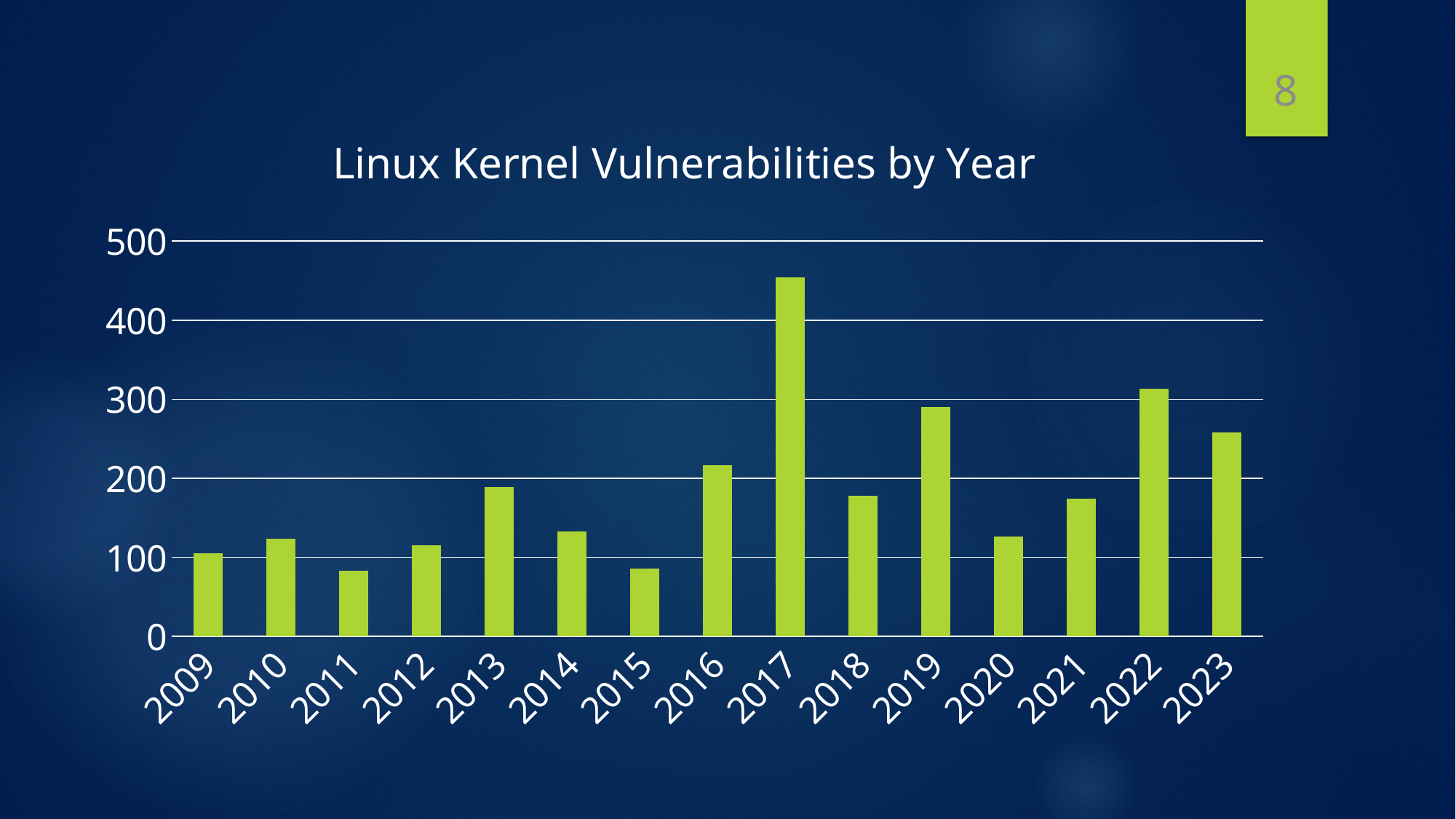
Is the value for 2013 greater or less than 200? less What kind of chart is shown on the slide? bar chart Is the value for 2016 greater or less than 200? greater What is the title of the chart? Linux Kernel Vulnerabilities by Year Is the value for 2011 greater or less than 100? less Do the values rise or fall from 2020 to 2022? rise Which year has the larger value, 2016 or 2018? 2016 Which year has the highest number of Linux kernel vulnerabilities? 2017 Which year has the larger value, 2022 or 2023? 2022 How many years are shown on the x axis of the chart? 15